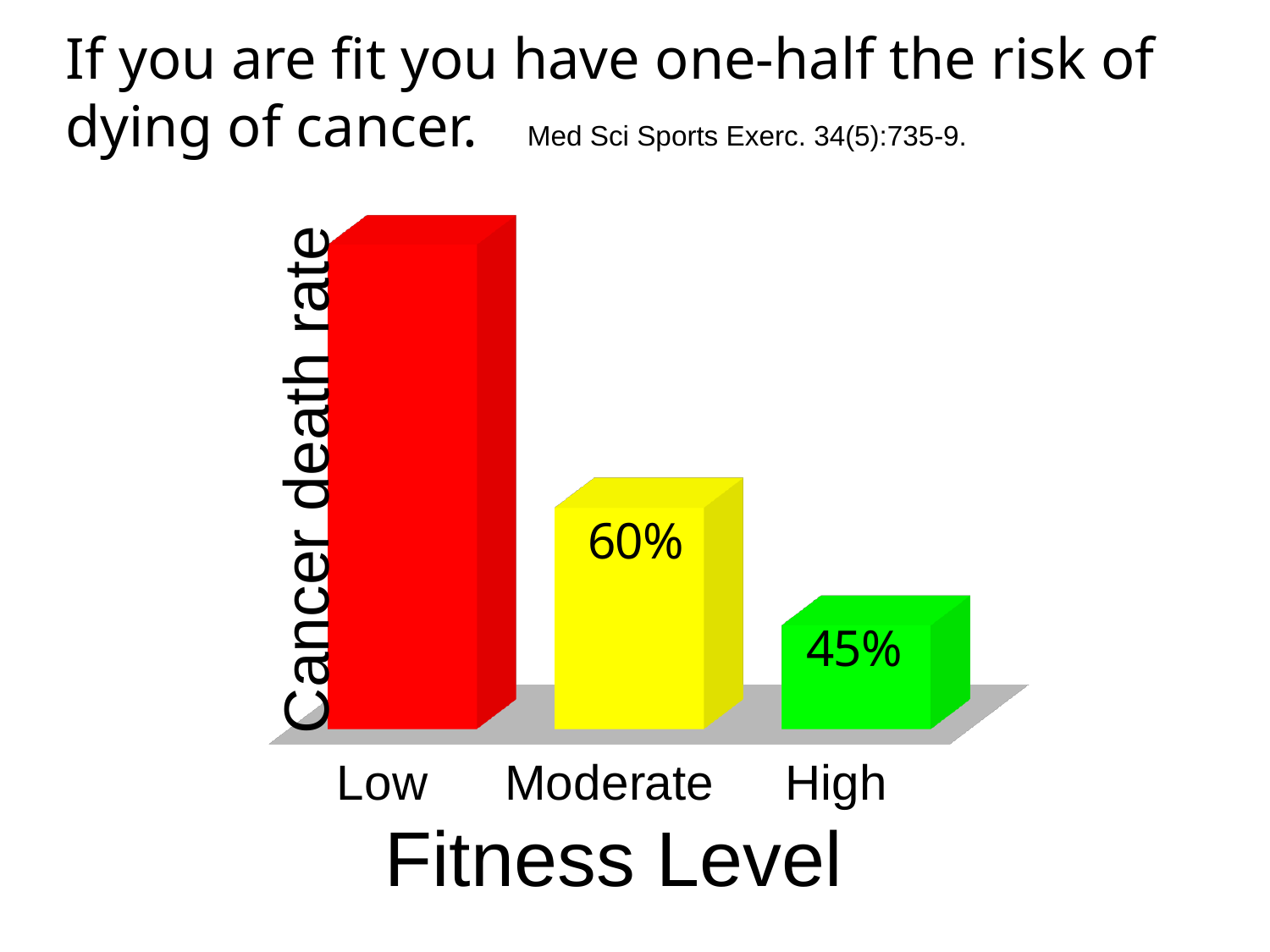
Which fitness level has the lowest cancer death rate bar? High What is the value for the High fitness level? 45% What is the difference between the values for Moderate and High fitness levels? 15% Which is larger, the value for Moderate or the value for High? Moderate How many fitness level categories are shown in the chart? 3 What kind of chart is shown on the slide? Bar chart Do the bars rise or fall from Low to High fitness level? Fall What colour is the bar for the High fitness level? Green What is the value for the Moderate fitness level? 60% Which fitness level has the highest cancer death rate bar? Low What is the title of the x axis? Fitness Level